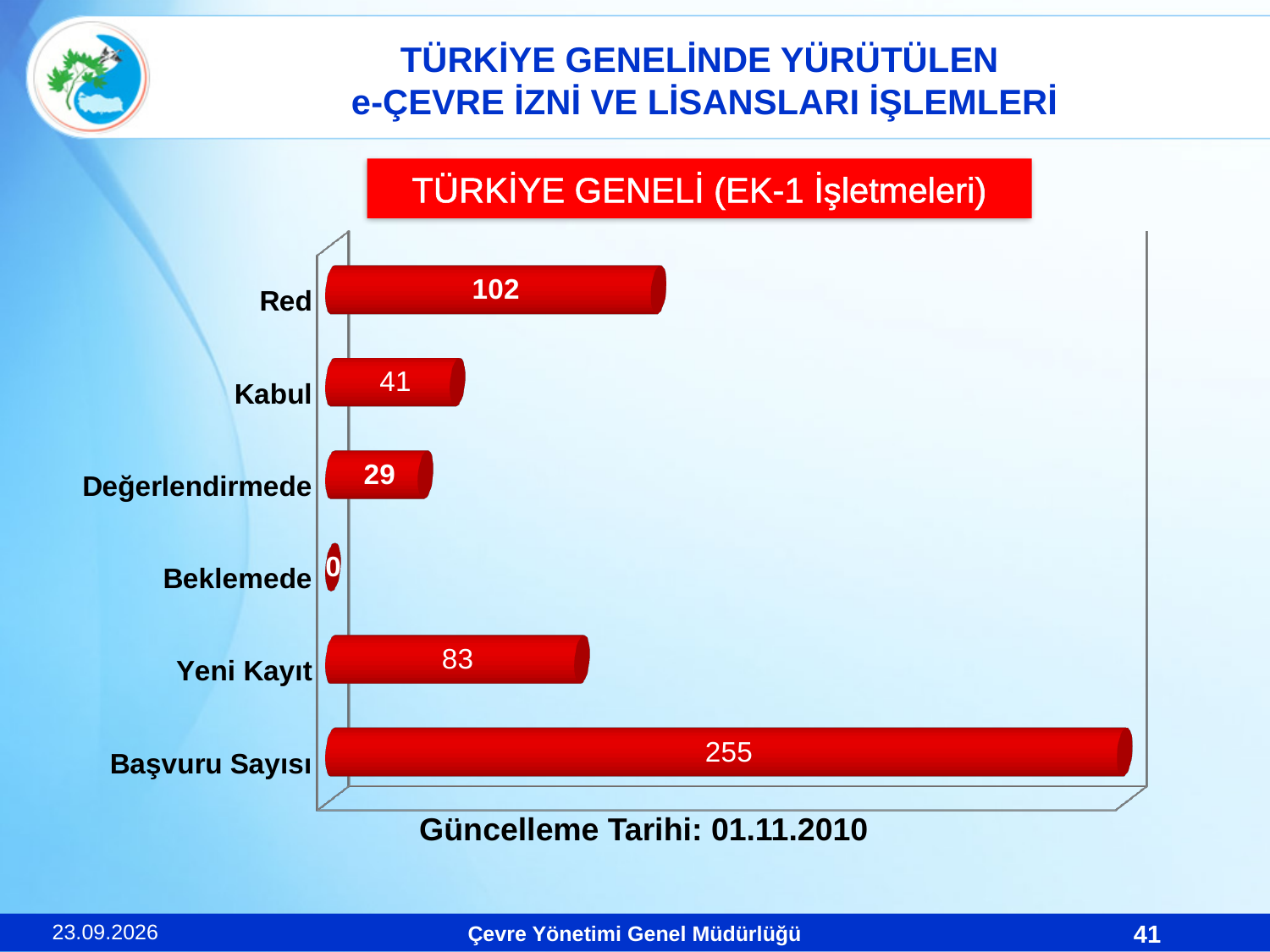
What is the value for Red? 102 What is the value for Beklemede? 0 What is the value for Başvuru Sayısı? 255 Which is larger, the value for Yeni Kayıt or the value for Red? Red What is the value for Yeni Kayıt? 83 What kind of chart is shown on the slide? Bar chart Which category has the highest value? Başvuru Sayısı How many categories are shown in the chart? 6 What is the value for Değerlendirmede? 29 What is the value for Kabul? 41 What is the difference between the values for Red and Kabul? 61 Which category has the lowest value? Beklemede